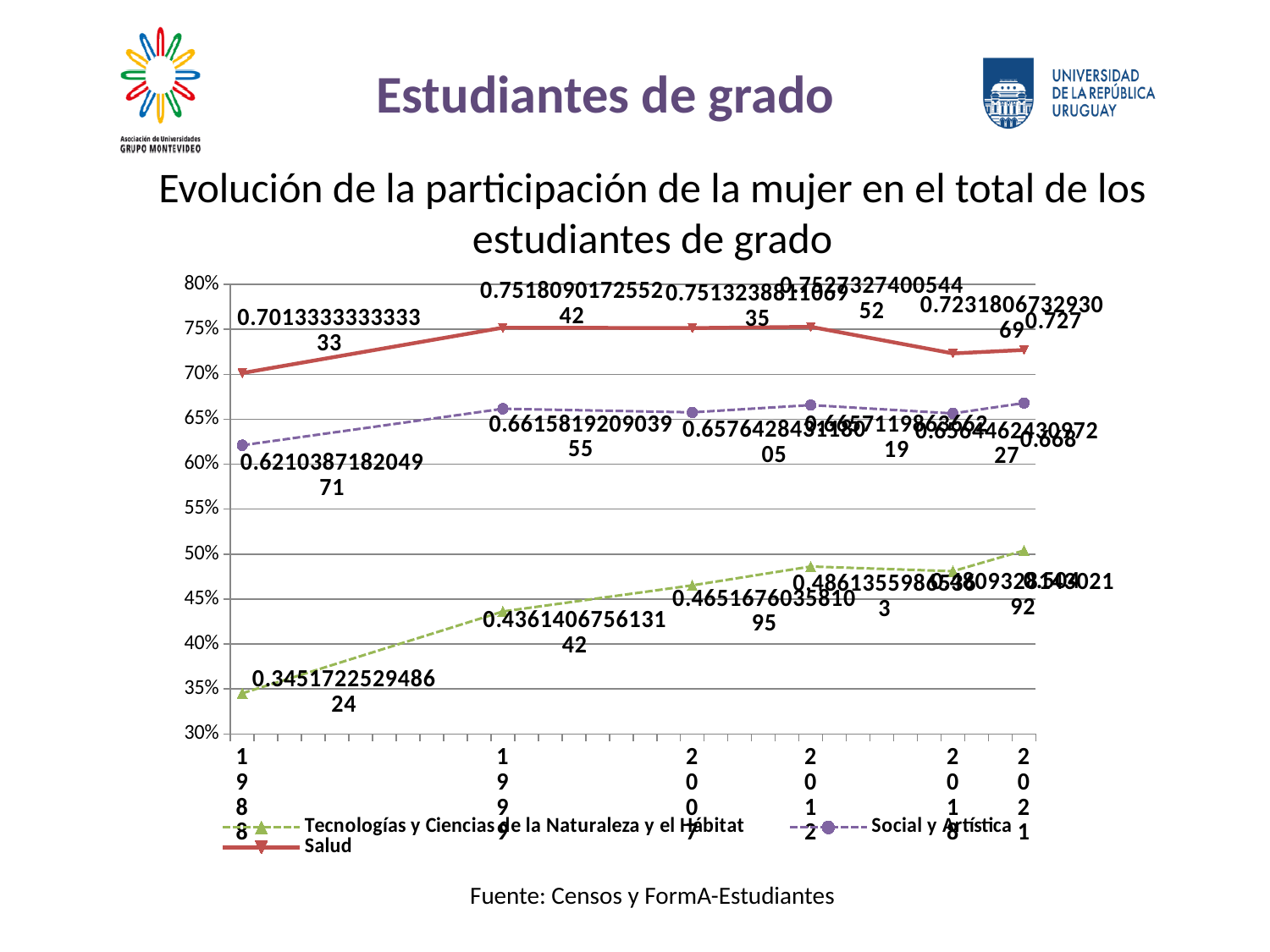
What is the value for Social y Artística in 2021? 0.668 In which year is the value for Tecnologías y Ciencias de la Naturaleza y el Hábitat lowest? 1988 How many years are plotted along the x axis? 6 How many series does the legend list? 3 Is the value for Salud in 2018 greater or less than 75%? less Which series has the larger value in 1988, Salud or Tecnologías y Ciencias de la Naturaleza y el Hábitat? Salud What is the value for Tecnologías y Ciencias de la Naturaleza y el Hábitat in 1988? 0.345172252948624 What is the value for Salud in 2021? 0.727 What is the value for Social y Artística in 1988? 0.621038718204971 Does the Tecnologías y Ciencias de la Naturaleza y el Hábitat series generally rise or fall from 1988 to 2021? rise What is the difference between Salud and Social y Artística in 2021? 0.059 What kind of chart is shown on the slide? line chart